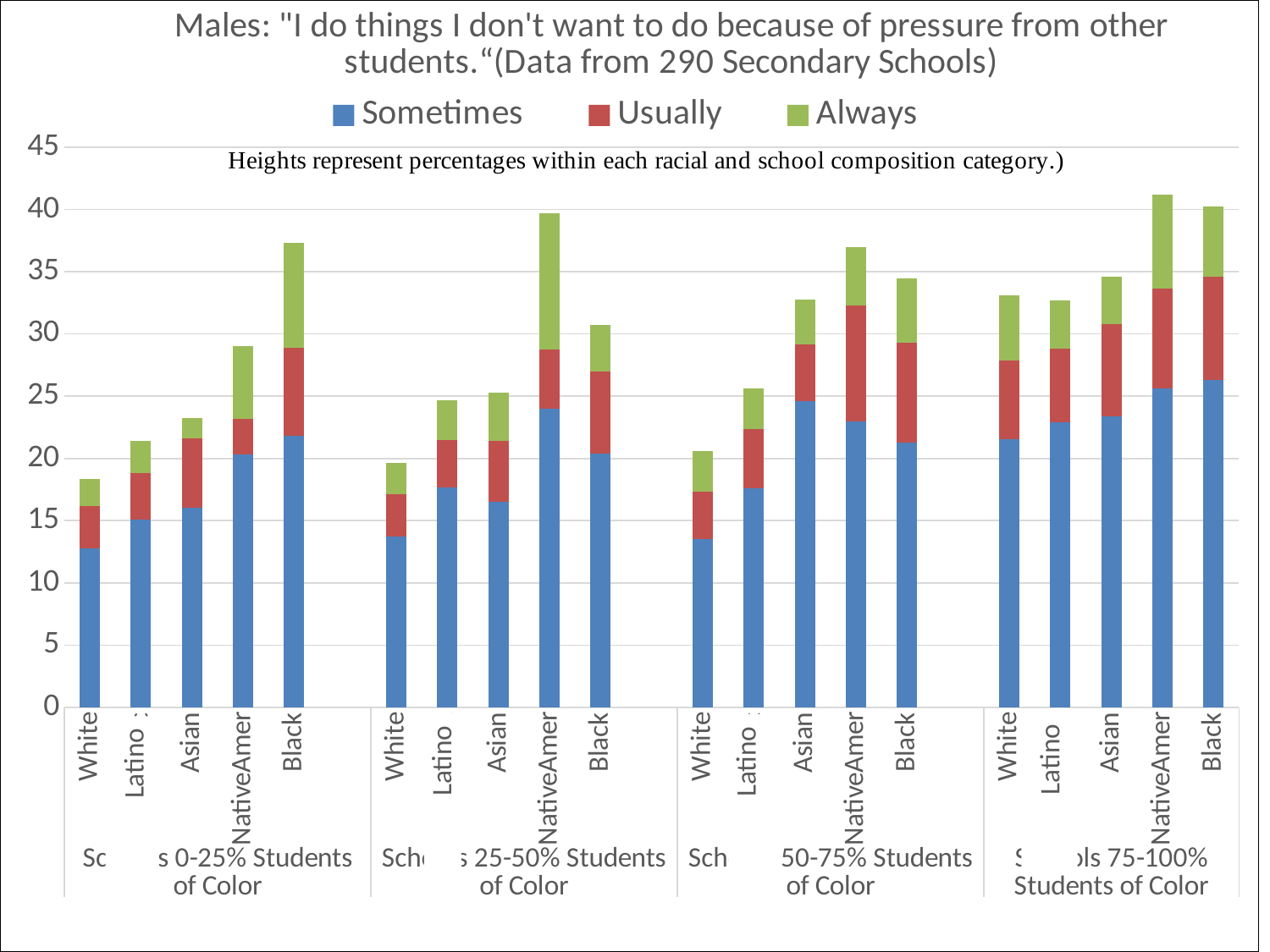
Is the total stacked value for Black in the Schools 0-25% Students of Color group greater or less than 35? greater Within the Schools 0-25% Students of Color group, which racial category has the tallest stacked bar? Black Is the total stacked value for White in the Schools 0-25% Students of Color group greater or less than 20? less How many bars are plotted in the chart in total? 20 Which series is shown in green in the legend? Always How many series does the legend list? 3 Is the total stacked value for Asian in the Schools 50-75% Students of Color group greater or less than 30? greater Within the Schools 25-50% Students of Color group, which racial category has the tallest stacked bar? NativeAmer Which is larger: the total stacked bar for Black in the Schools 0-25% Students of Color group or for Black in the Schools 25-50% Students of Color group? Black in Schools 0-25% Students of Color What kind of chart is shown on the slide? Stacked bar chart Within the Schools 0-25% Students of Color group, which racial category has the shortest stacked bar? White